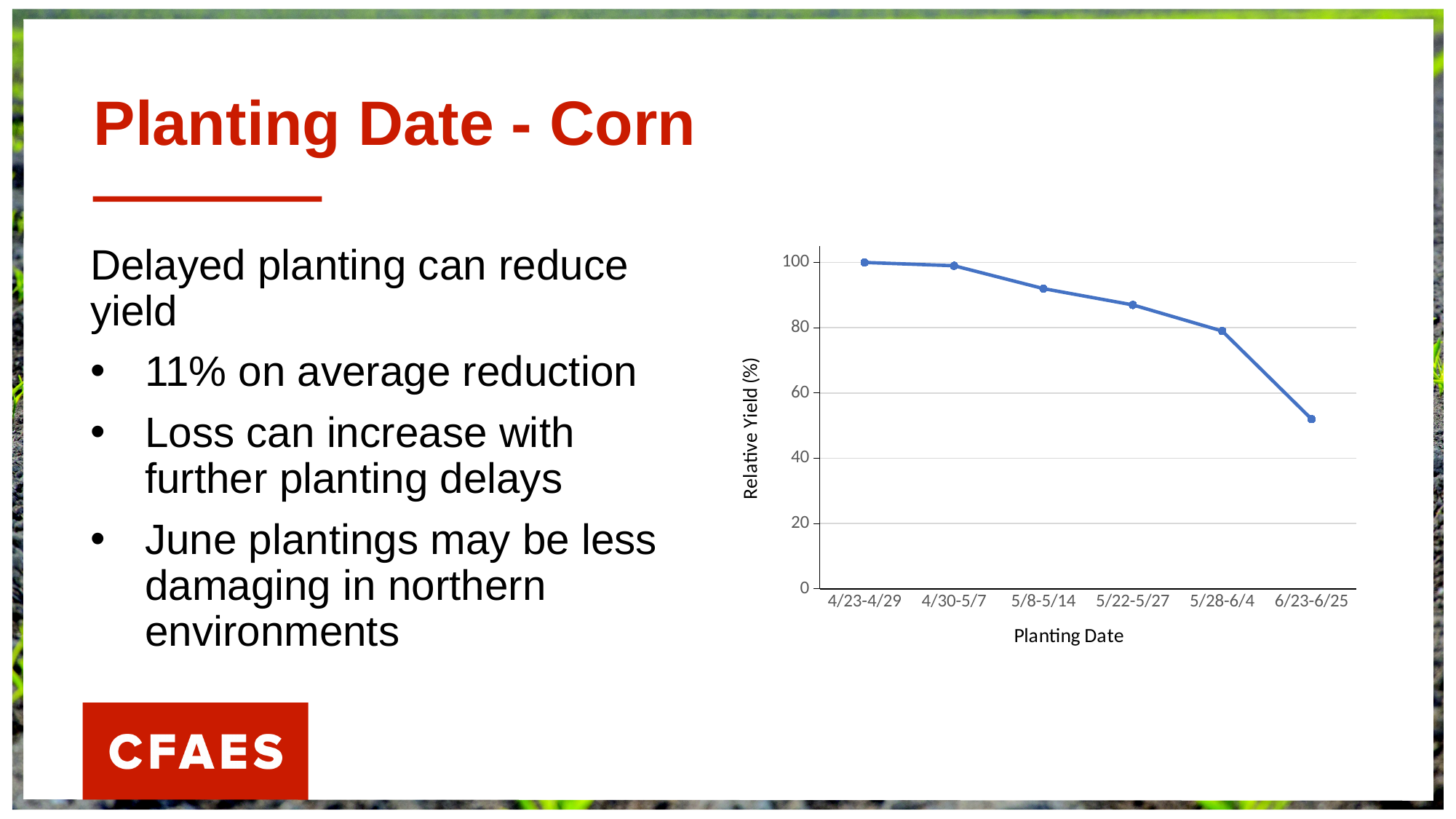
What is the label of the y axis? Relative Yield (%) Is the relative yield for 5/8-5/14 greater or less than 80? greater Which planting date has the lowest relative yield? 6/23-6/25 What is the label of the x axis? Planting Date Is the relative yield for 6/23-6/25 greater or less than 60? less Is the relative yield for 5/22-5/27 greater or less than 80? greater Which has the larger relative yield, 5/8-5/14 or 6/23-6/25? 5/8-5/14 How many planting date categories are plotted on the x axis? 6 Do the relative yield values rise or fall as planting date moves later along the x axis? fall What kind of chart is shown on the slide? line chart What is the relative yield (%) for the 4/23-4/29 planting date? 100